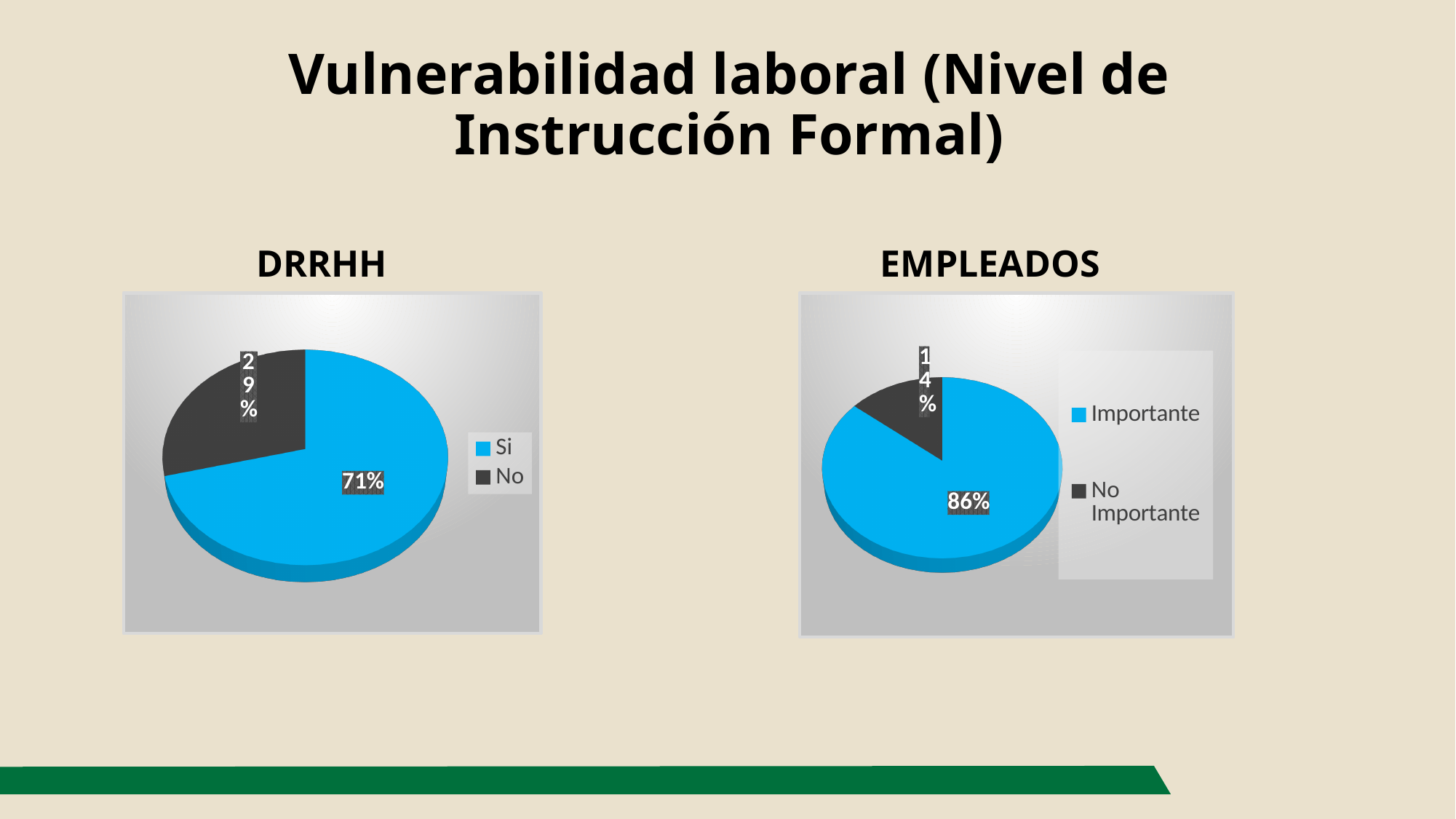
In the EMPLEADOS chart, which slice is the smallest? No Importante In the DRRHH chart, which slice is the largest? Si How many categories does the EMPLEADOS chart's legend list? 2 What colour is the Si slice in the DRRHH chart? Blue In the EMPLEADOS chart, what is the difference between the Importante and No Importante percentages? 72% In the DRRHH chart, what percentage is shown for No? 29% In the EMPLEADOS chart, what percentage is shown for Importante? 86% What type of chart is the DRRHH chart? Pie chart In the EMPLEADOS chart, what percentage is shown for No Importante? 14% Which is larger: the Si share in the DRRHH chart or the Importante share in the EMPLEADOS chart? Importante in the EMPLEADOS chart In the DRRHH chart, what percentage is shown for Si? 71% In the DRRHH chart, what is the difference between the Si and No percentages? 42%